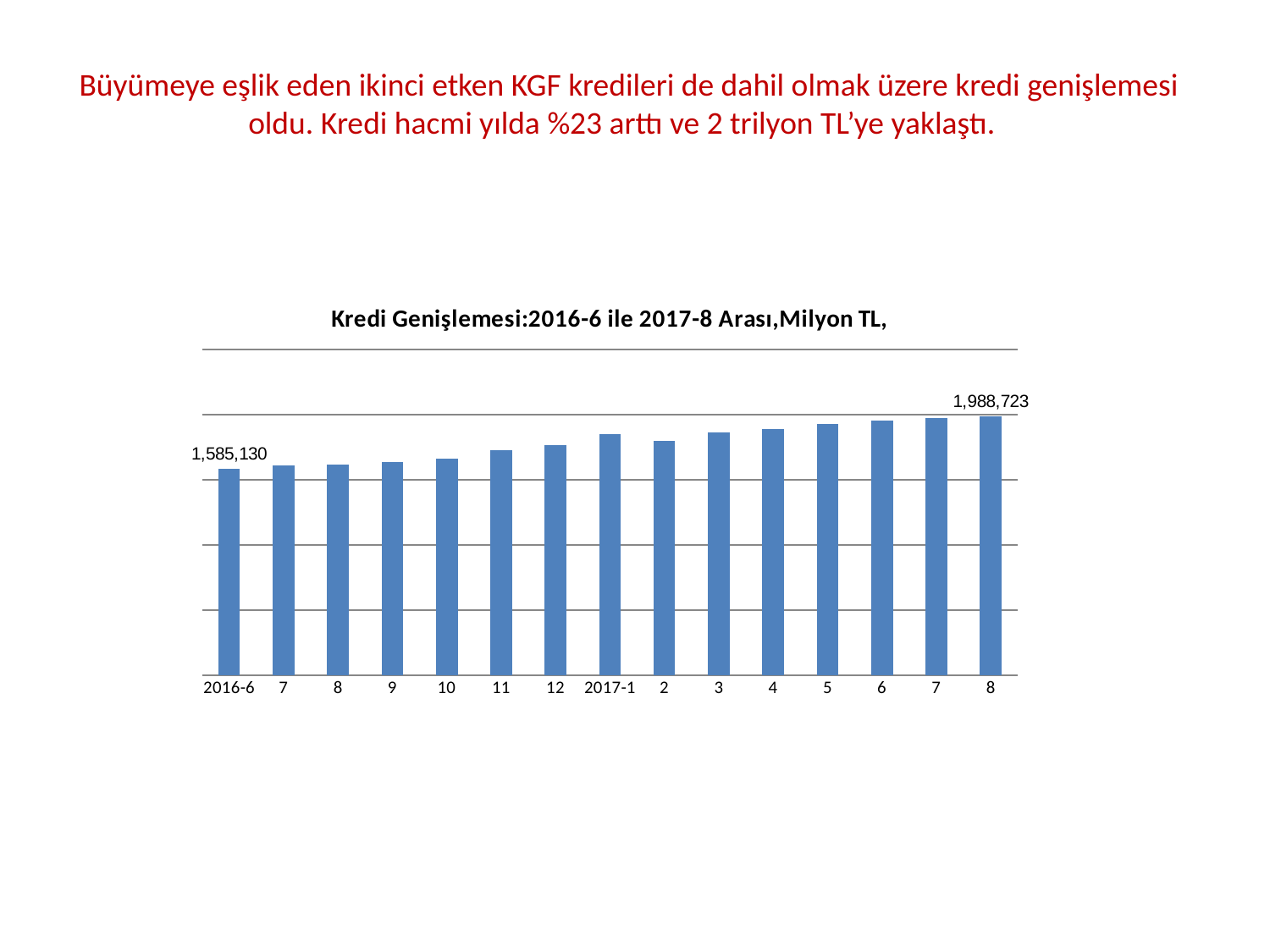
Which period has the lowest value? 2016-6 What is the difference between the values for 2017-8 and 2016-6? 403,593 What is the value for 2017-8? 1,988,723 What type of chart is shown on the slide? Bar chart What is the title of the chart? Kredi Genişlemesi:2016-6 ile 2017-8 Arası,Milyon TL, What is the value for 2016-6? 1,585,130 Which period has the highest value? 2017-8 What colour are the bars in the chart? Blue Which is larger, the value for 2017-3 or the value for 2017-6? 2017-6 How many bars are plotted in the chart? 15 Which is larger, the value for 2016-9 or the value for 2016-12? 2016-12 Do the values generally rise or fall from 2016-6 to 2017-8? Rise